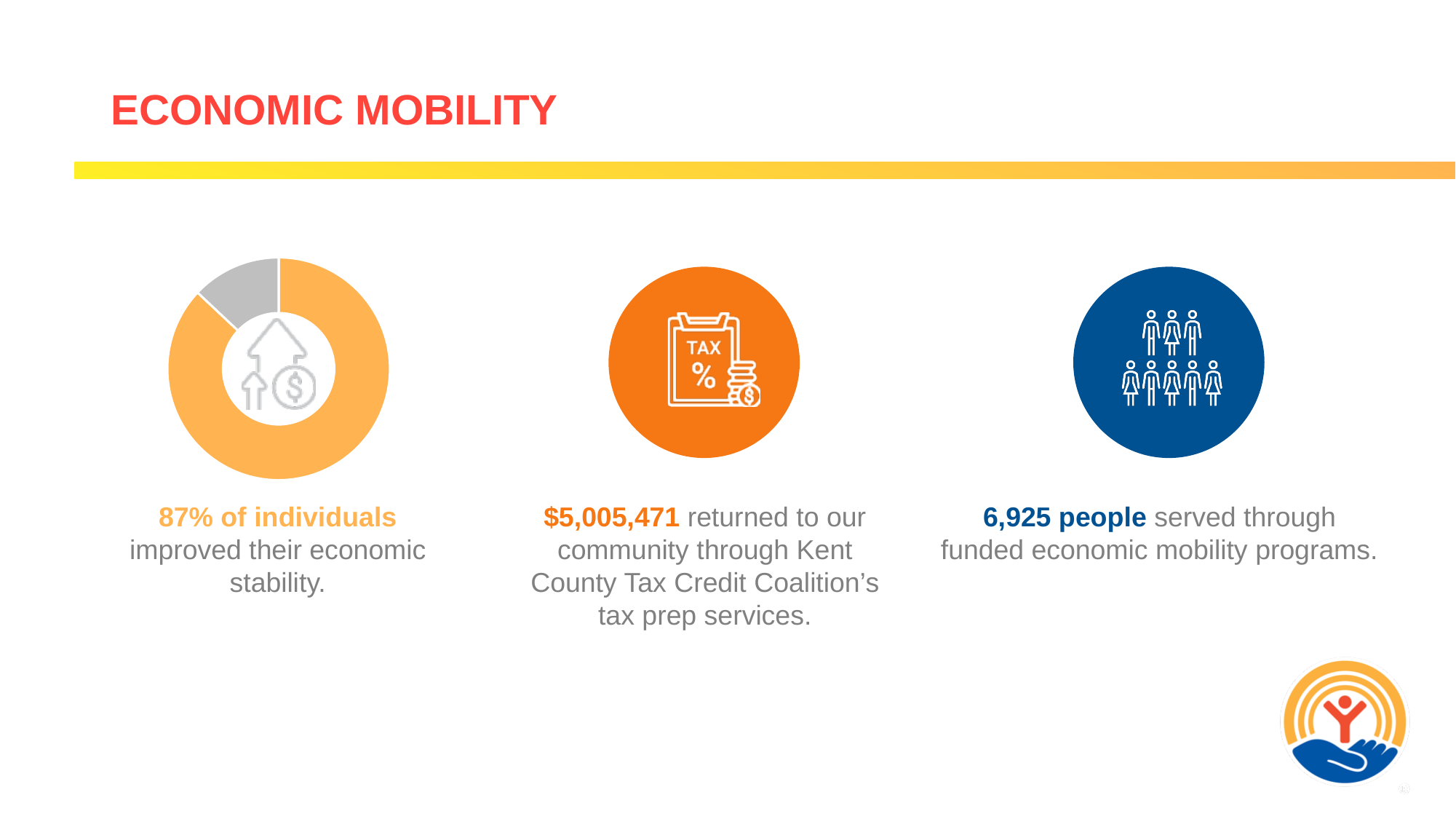
What share of the donut chart is taken by the orange slice? 87% How many slices does the donut chart have? 2 What colour is the smaller slice of the donut chart? gray What does the 87% slice of the donut chart represent according to the caption below it? individuals who improved their economic stability Which slice is the largest in the donut chart? the orange slice (87%) Is the orange slice of the donut chart greater or less than 50% of the whole? greater Which slice of the donut chart is larger, the orange one or the gray one? orange What kind of chart is shown on the left of the slide? donut (pie) chart